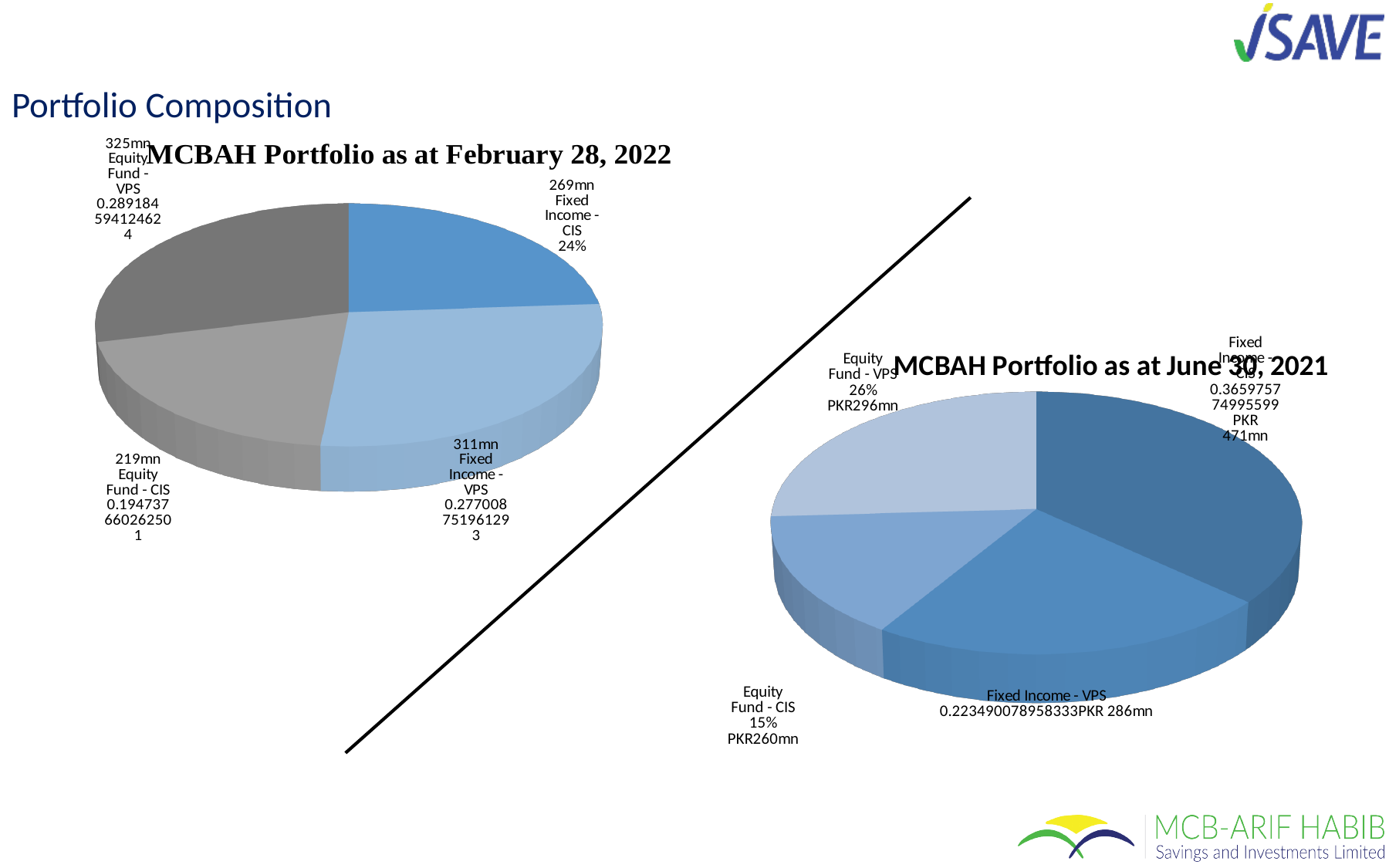
In the MCBAH Portfolio as at February 28, 2022 chart, what is the difference between Fixed Income - VPS and Equity Fund - CIS? 92mn In the MCBAH Portfolio as at June 30, 2021 chart, what is the value for Equity Fund - CIS? PKR260mn In the MCBAH Portfolio as at February 28, 2022 chart, what is the value for Equity Fund - VPS? 325mn In the MCBAH Portfolio as at February 28, 2022 chart, which category has the largest value? Equity Fund - VPS In the MCBAH Portfolio as at June 30, 2021 chart, which is larger, Equity Fund - VPS or Fixed Income - VPS? Equity Fund - VPS In the MCBAH Portfolio as at February 28, 2022 chart, what share of the pie is Fixed Income - CIS? 24% In the MCBAH Portfolio as at June 30, 2021 chart, what share of the pie is Equity Fund - VPS? 26% In the MCBAH Portfolio as at February 28, 2022 chart, what is the value for Fixed Income - CIS? 269mn In the MCBAH Portfolio as at June 30, 2021 chart, what is the value for Fixed Income - CIS? PKR 471mn In the MCBAH Portfolio as at February 28, 2022 chart, which category has the smallest value? Equity Fund - CIS How many slices does the MCBAH Portfolio as at June 30, 2021 chart have? 4 In the MCBAH Portfolio as at June 30, 2021 chart, which category has the largest value? Fixed Income - CIS